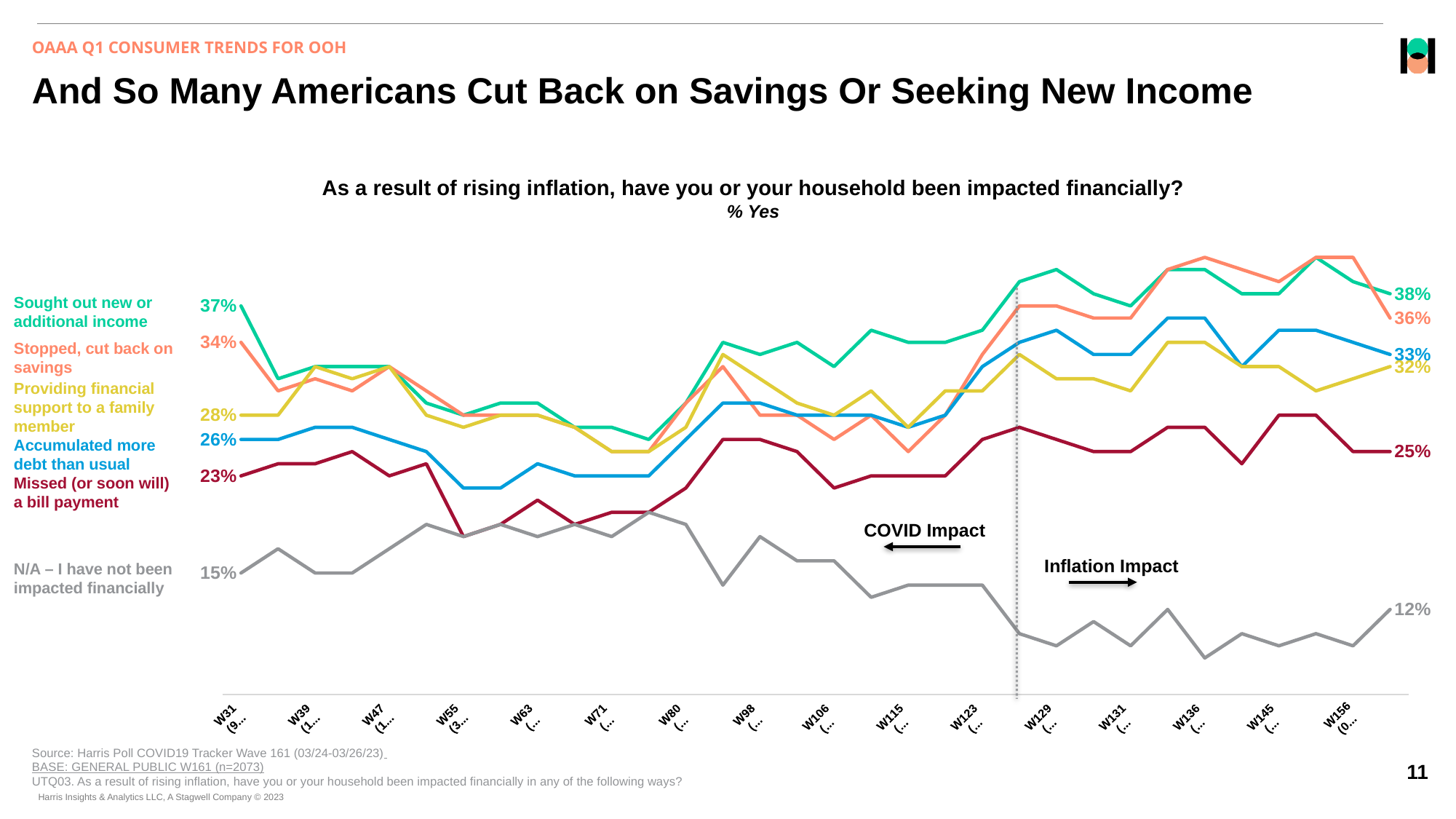
Does the 'N/A – I have not been impacted financially' series rise or fall from W31 to W156? fall What is the starting value for 'Sought out new or additional income' at W31? 37% What is the starting value for 'N/A – I have not been impacted financially' at W31? 15% What question is the chart titled with? As a result of rising inflation, have you or your household been impacted financially? Which series has the lowest value at the final wave (W156)? N/A – I have not been impacted financially How many series does the chart show? 6 What type of chart is shown on the slide? line chart At W156, which is larger: 'Missed (or soon will) a bill payment' or 'Providing financial support to a family member'? Providing financial support to a family member